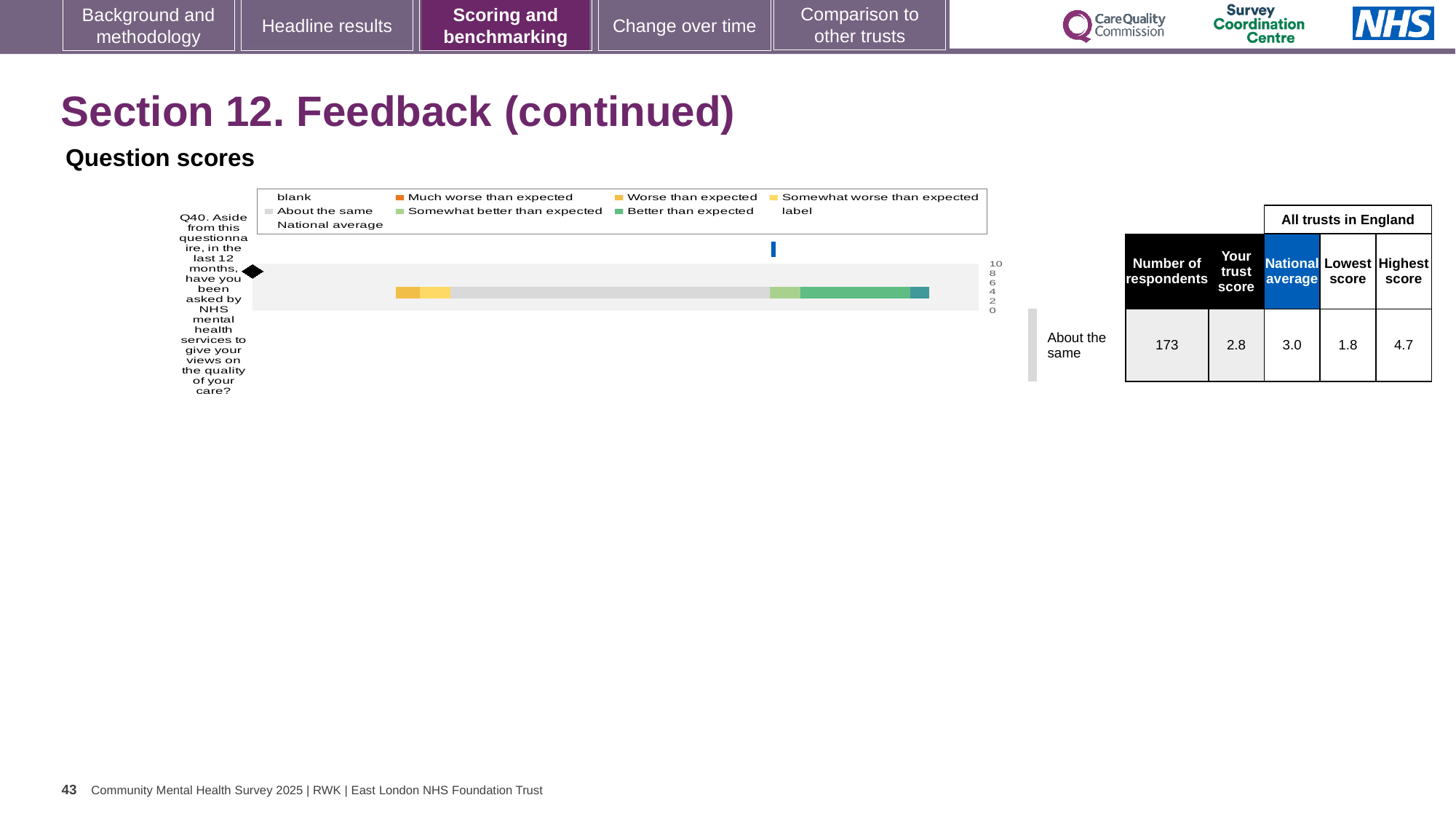
In the table beside the chart, which is larger for Q40: the trust score or the national average? national average In the table beside the chart, what is the lowest score among all trusts in England for Q40? 1.8 In the table beside the chart, what is 'Your trust score' for Q40? 2.8 How many questions (categories) are plotted in the bar chart? 1 In the table beside the chart, what is the number of respondents for Q40? 173 In the chart legend, what colour represents 'Better than expected'? green In the table beside the chart, what is the national average for Q40? 3.0 What kind of chart is shown under 'Question scores'? bar chart In the table beside the chart, what is the difference between the highest score and the lowest score for Q40? 2.9 What is the highest value shown on the chart's axis? 10 In the table beside the chart, what is the highest score among all trusts in England for Q40? 4.7 Which question number is plotted in the bar chart? Q40